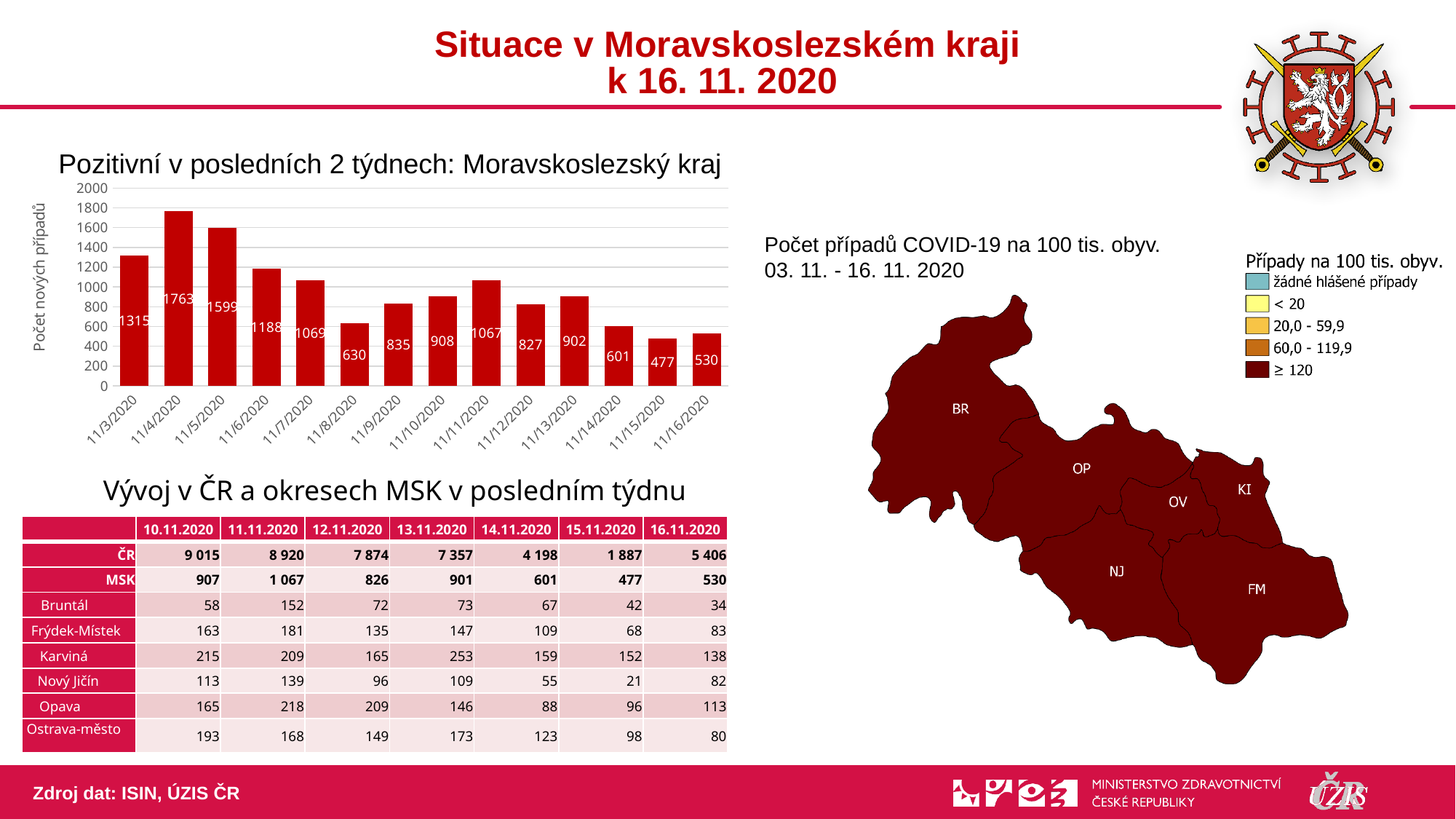
In the bar chart, is the value for 11/6/2020 greater or less than 1000? greater In the bar chart, what is the value for 11/8/2020? 630 In the bar chart, what is the value for 11/16/2020? 530 Which date has the lowest value in the bar chart? 11/15/2020 In the bar chart, what is the difference between the values for 11/3/2020 and 11/16/2020? 785 In the bar chart, what is the difference between the values for 11/4/2020 and 11/5/2020? 164 How many dates (bars) are shown in the bar chart? 14 What type of chart is shown under the title 'Pozitivní v posledních 2 týdnech: Moravskoslezský kraj'? bar chart What is the label of the vertical axis of the bar chart? Počet nových případů In the bar chart, what is the value for 11/4/2020? 1763 In the bar chart, which is larger: the value for 11/10/2020 or the value for 11/13/2020? 11/10/2020 Which date has the highest value in the bar chart? 11/4/2020